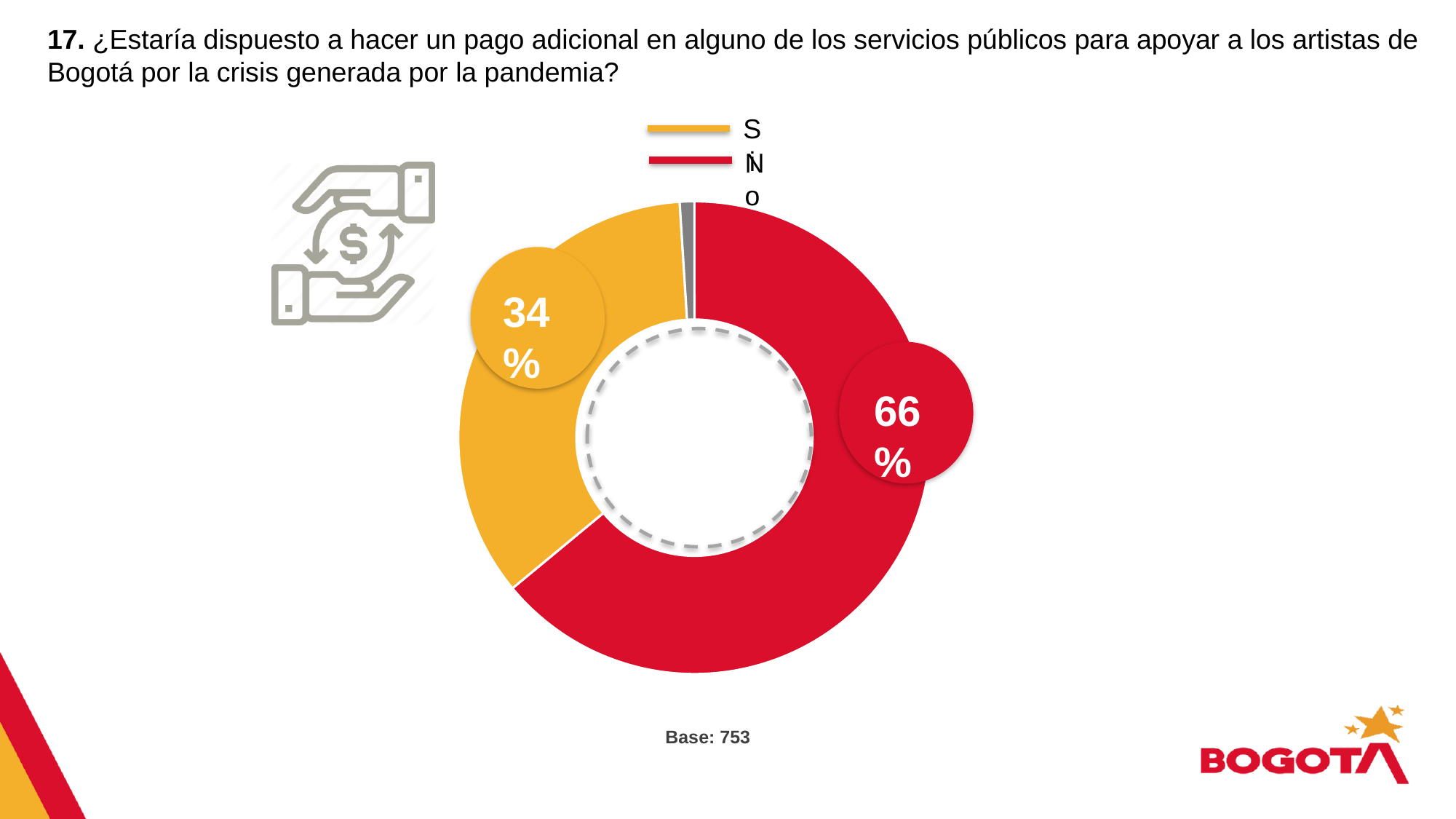
Which response has the largest share of the pie? No How many entries does the legend list? 2 What colour is the "No" slice? red Which labelled response has the smaller share, "Sí" or "No"? Sí By how many percentage points does "No" exceed "Sí"? 32 percentage points What percentage of respondents answered "No"? 66% What is the base (number of respondents) shown below the chart? 753 What kind of chart is shown on the slide? pie chart (donut) What percentage of respondents answered "Sí"? 34% What share of the pie does the "No" slice represent? 66% Is the share for "Sí" larger or smaller than the share for "No"? smaller